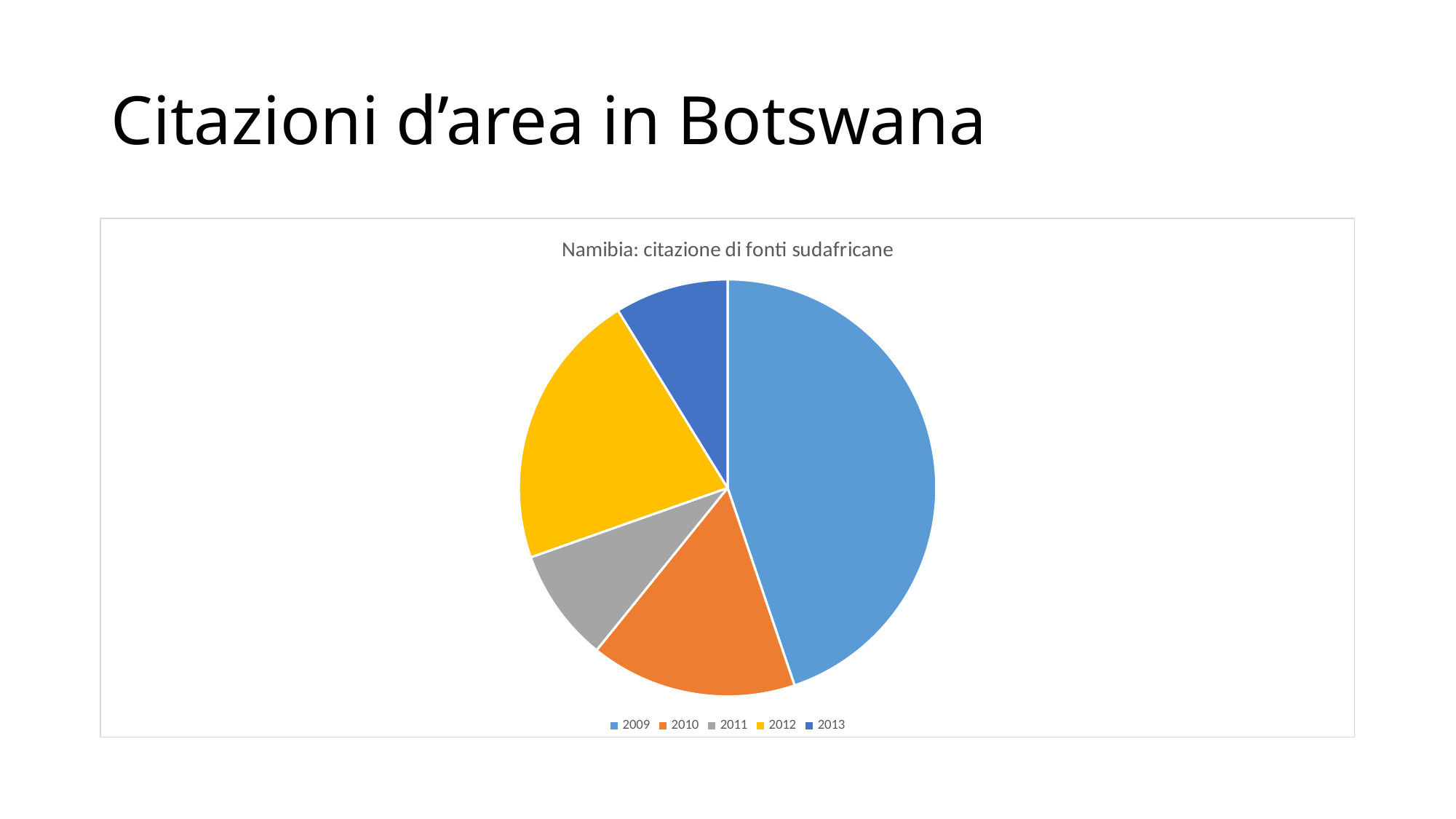
What colour is the slice for 2012? yellow Which year has the largest slice of the pie? 2009 Which slice is larger, 2012 or 2010? 2012 Which slice is larger, 2012 or 2013? 2012 What kind of chart is shown on the slide? pie chart Which slice is larger, 2009 or 2012? 2009 How many slices does the pie chart have? 5 How many entries does the legend list? 5 What is the title of the chart? Namibia: citazione di fonti sudafricane